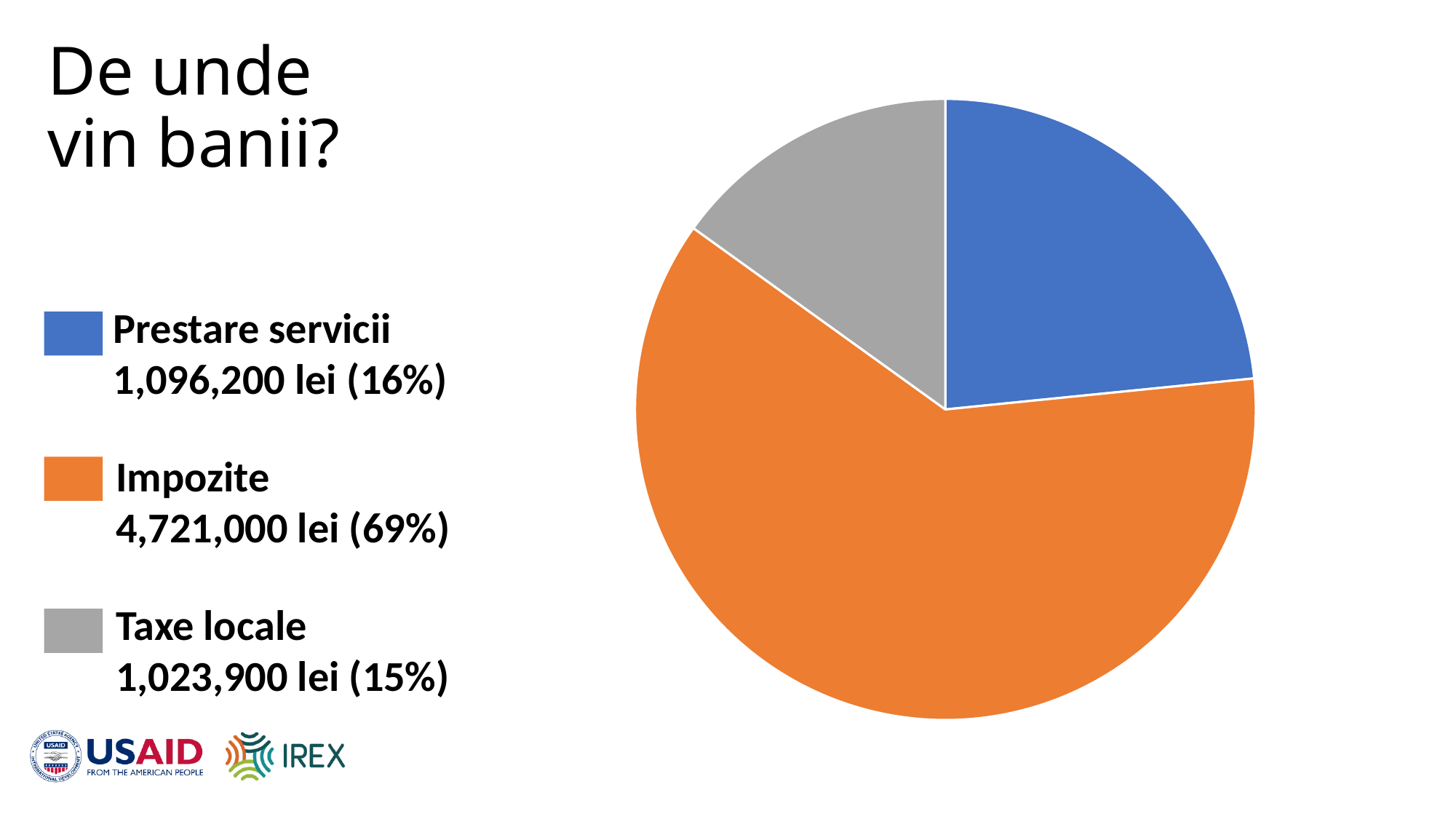
What share of the pie does Impozite represent? 69% Which category has the smallest share of the pie? Taxe locale Which is larger, the value for Prestare servicii or the value for Taxe locale? Prestare servicii What kind of chart is shown on the slide? pie chart What is the value for Taxe locale? 1,023,900 lei What share of the pie does Taxe locale represent? 15% How many categories does the pie chart have? 3 What is the difference between the values for Impozite and Prestare servicii? 3,624,800 lei What is the value for Impozite? 4,721,000 lei Which category has the largest share of the pie? Impozite What is the value for Prestare servicii? 1,096,200 lei What colour is the slice for Impozite? orange